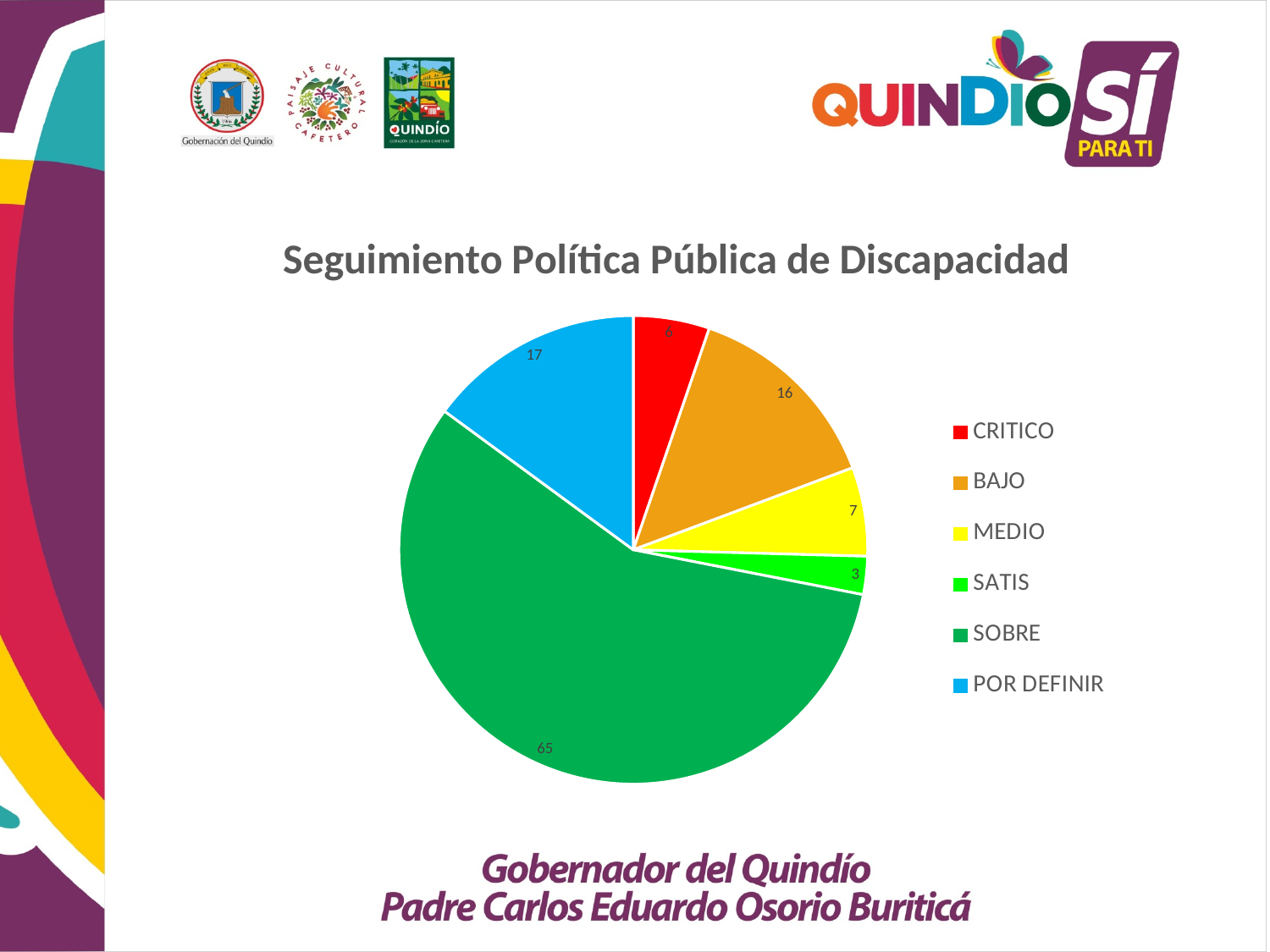
What is the title of the chart? Seguimiento Política Pública de Discapacidad What is the value for POR DEFINIR? 17 What is the difference between the values for SOBRE and POR DEFINIR? 48 What is the value for MEDIO? 7 What is the total of all the slices in the pie chart? 114 Which is larger, the value for BAJO or the value for MEDIO? BAJO Which category has the largest slice? SOBRE How many categories does the pie chart have? 6 Which category has the smallest slice? SATIS What type of chart is shown on the slide? pie chart What is the value for SOBRE? 65 What is the value for CRITICO? 6